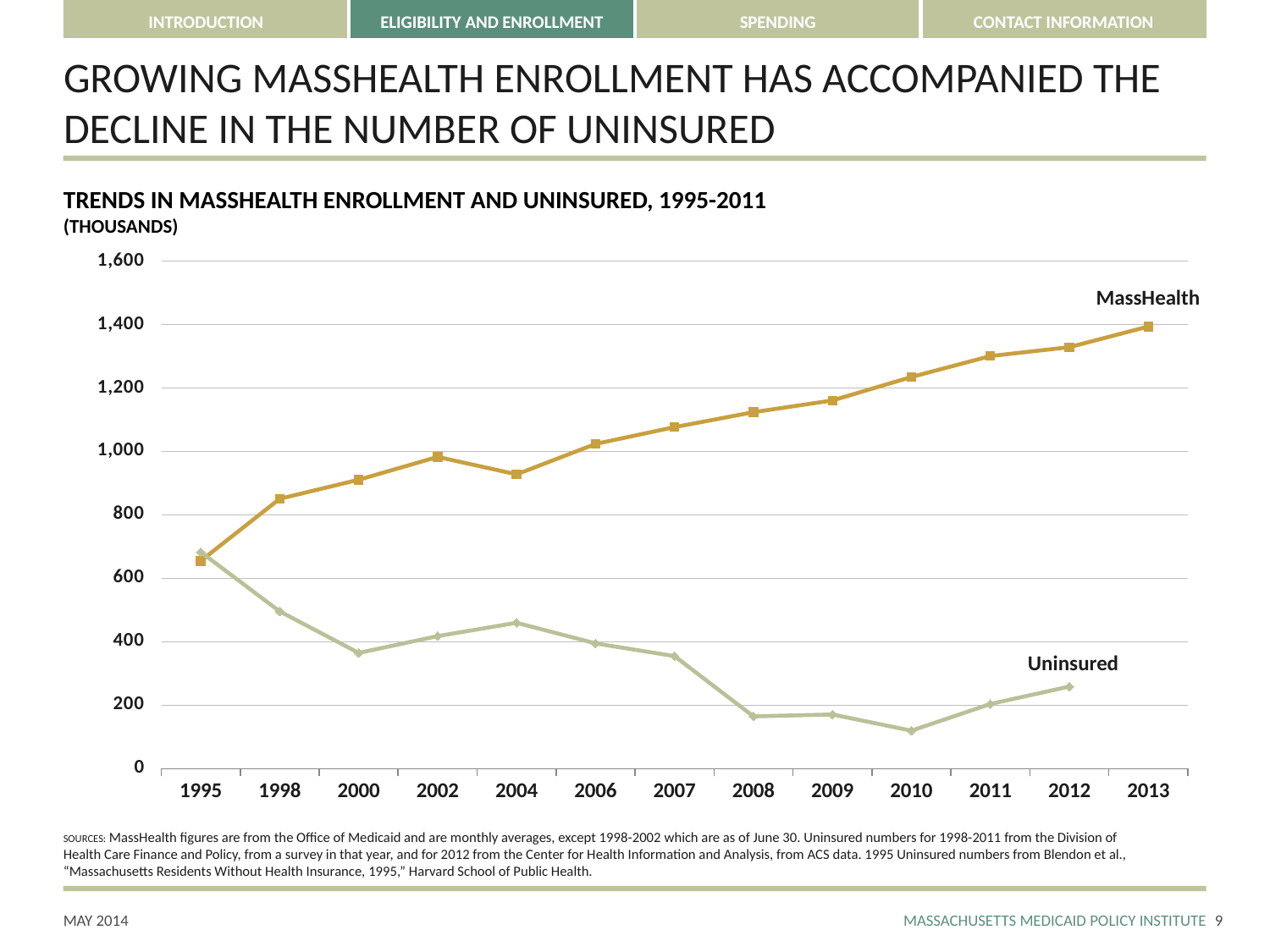
In 2004, which series has the larger value, MassHealth or Uninsured? MassHealth In which year does the MassHealth line reach its highest value? 2013 In which year is the Uninsured line at its lowest value? 2010 What kind of chart is shown on the slide? Line chart Is the Uninsured value for 2010 greater or less than 200? less Is the MassHealth value for 1995 greater or less than 800? less Is the Uninsured value for 2004 greater or less than 400? greater How many years are marked along the x axis of the chart? 13 In which year is the Uninsured line at its highest value? 1995 Does the Uninsured line generally rise or fall from 1995 to 2010? Fall How many series are plotted on the chart? 2